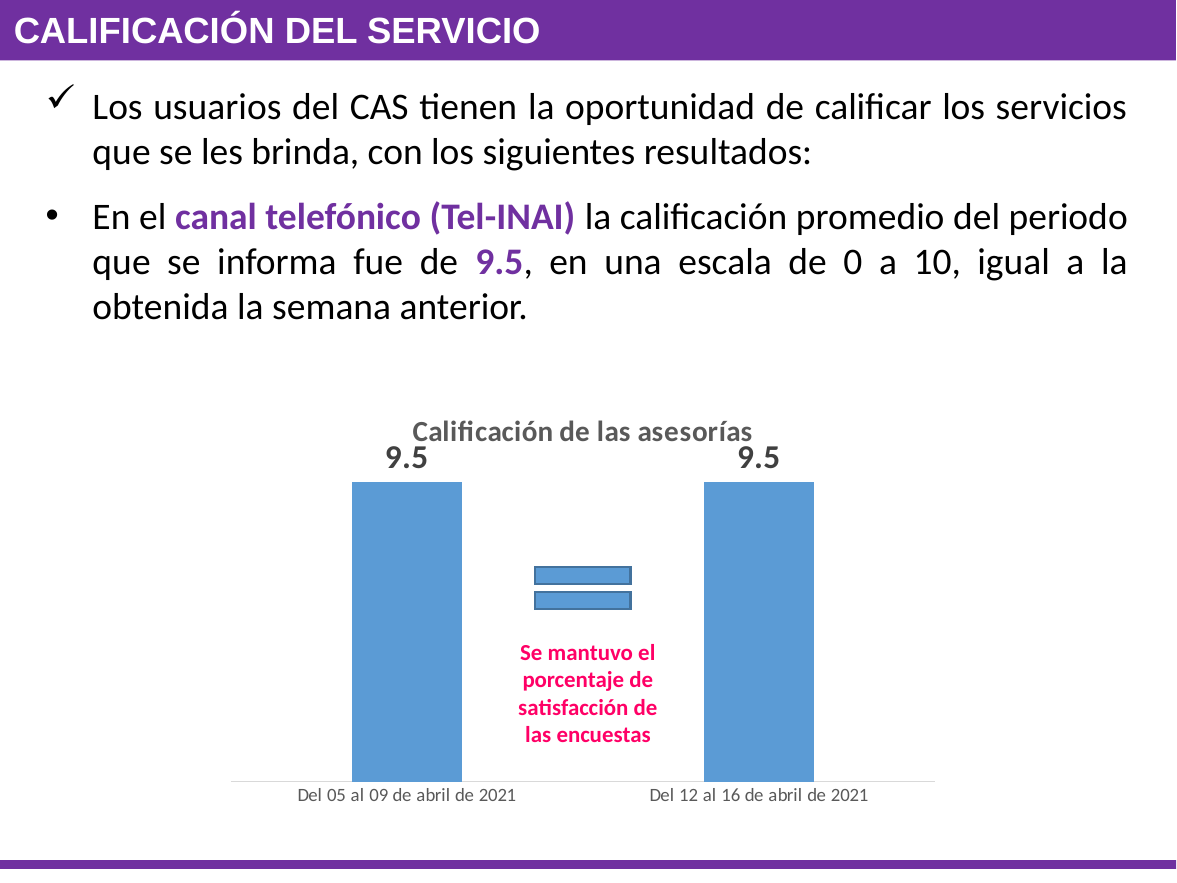
What is the value for 'Del 05 al 09 de abril de 2021' in the 'Calificación de las asesorías' chart? 9.5 Do the values rise, fall or stay the same from 'Del 05 al 09 de abril de 2021' to 'Del 12 al 16 de abril de 2021'? Stay the same What is the difference between the values for 'Del 12 al 16 de abril de 2021' and 'Del 05 al 09 de abril de 2021'? 0 What colour are the bars in the 'Calificación de las asesorías' chart? Blue How many categories are shown in the 'Calificación de las asesorías' chart? 2 What is the value for 'Del 12 al 16 de abril de 2021' in the 'Calificación de las asesorías' chart? 9.5 What kind of chart is 'Calificación de las asesorías'? Bar chart What is the title of the chart on the slide? Calificación de las asesorías